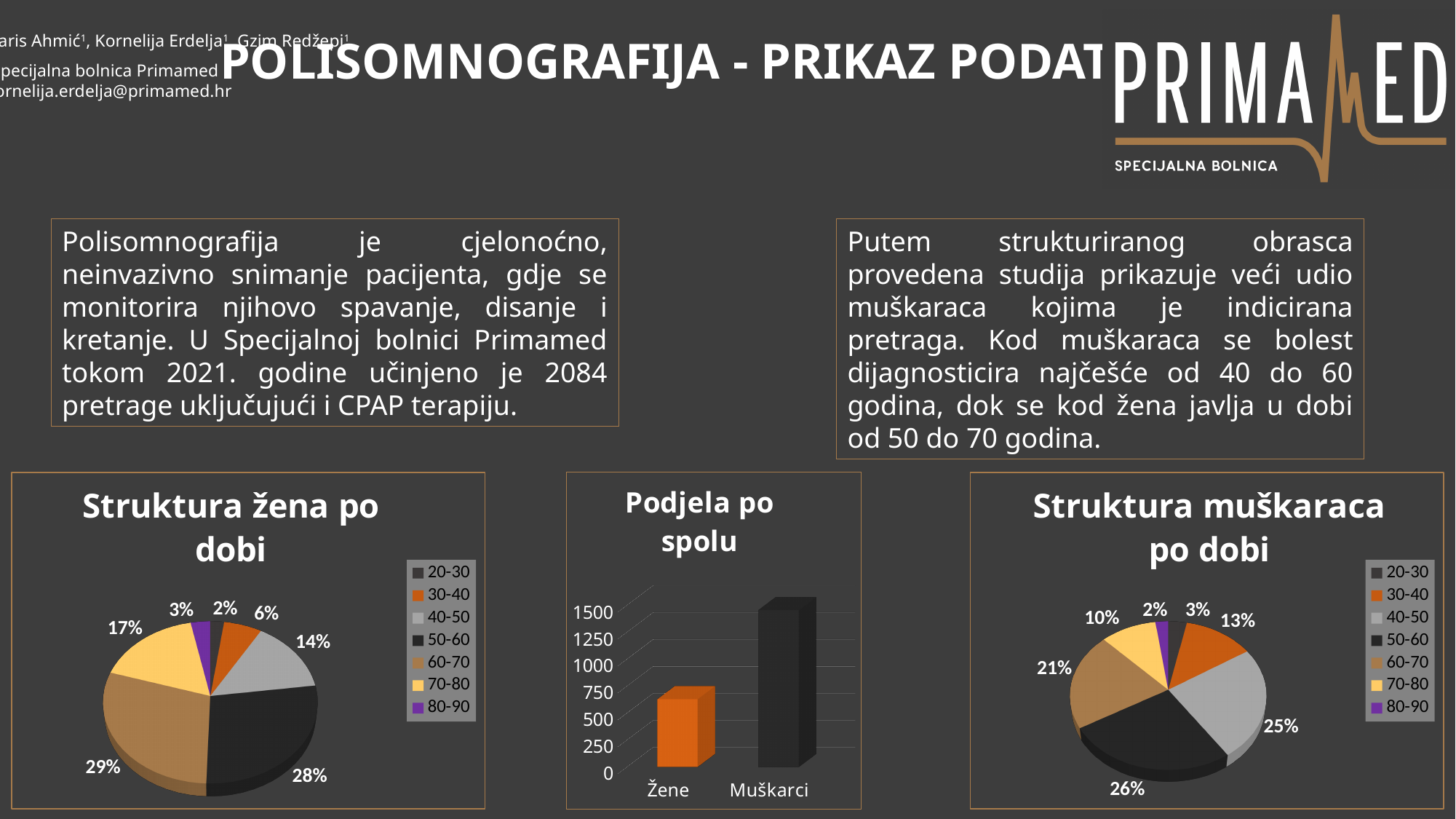
In the 'Struktura muškaraca po dobi' chart, which is larger, the share for 60-70 or for 30-40? 60-70 In the 'Struktura žena po dobi' chart, what share is shown for the 40-50 age group? 14% In the 'Struktura muškaraca po dobi' chart, what share is shown for the 40-50 age group? 25% What kind of chart is 'Podjela po spolu'? bar chart In the 'Podjela po spolu' chart, is the value for Muškarci greater or less than 1250? greater In the 'Struktura žena po dobi' chart, which age group has the smallest share? 20-30 In the 'Struktura muškaraca po dobi' chart, what share is shown for the 70-80 age group? 10% In the 'Podjela po spolu' chart, which category has the larger value, Žene or Muškarci? Muškarci In the 'Podjela po spolu' chart, is the value for Žene greater or less than 1000? less In the 'Struktura žena po dobi' chart, what share is shown for the 60-70 age group? 29% How many age groups does the legend of the 'Struktura žena po dobi' chart list? 7 In the 'Struktura žena po dobi' chart, what is the difference between the 50-60 and 30-40 shares? 22%